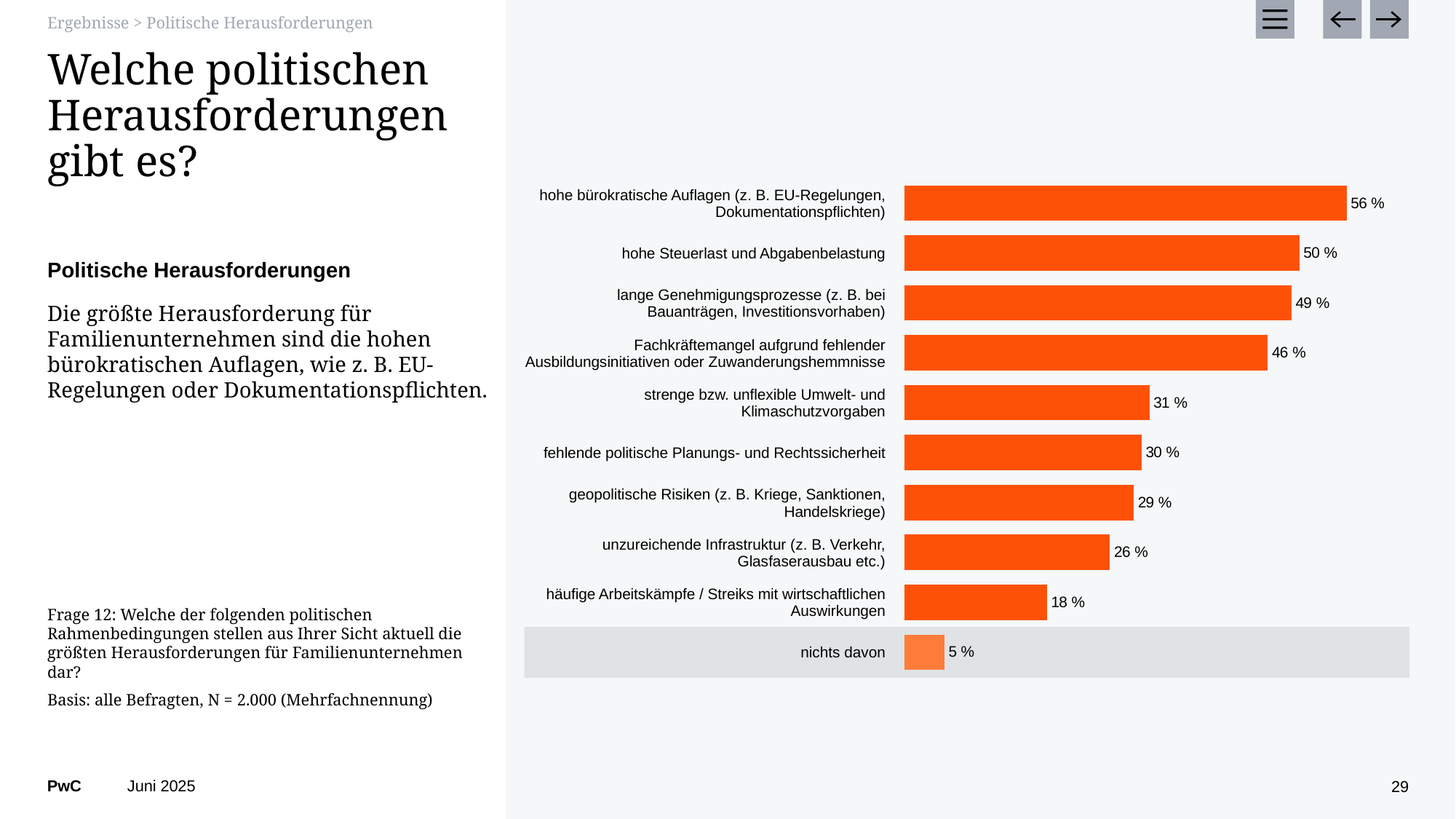
What is the difference between the values for "unzureichende Infrastruktur" and "häufige Arbeitskämpfe / Streiks"? 8 % What is the value for "häufige Arbeitskämpfe / Streiks mit wirtschaftlichen Auswirkungen"? 18 % Which category has the lowest value? nichts davon Which is larger: the value for "strenge bzw. unflexible Umwelt- und Klimaschutzvorgaben" or for "geopolitische Risiken"? strenge bzw. unflexible Umwelt- und Klimaschutzvorgaben What is the value for "nichts davon"? 5 % What is the difference between the values for "hohe bürokratische Auflagen" and "hohe Steuerlast und Abgabenbelastung"? 6 % Which category has the highest value? hohe bürokratische Auflagen (z. B. EU-Regelungen, Dokumentationspflichten) What kind of chart is shown on the slide? bar chart What is the value for "hohe Steuerlast und Abgabenbelastung"? 50 % Which bar is shown in a lighter orange colour than the others? nichts davon How many categories are shown in the chart? 10 What is the value for "Fachkräftemangel aufgrund fehlender Ausbildungsinitiativen oder Zuwanderungshemmnisse"? 46 %